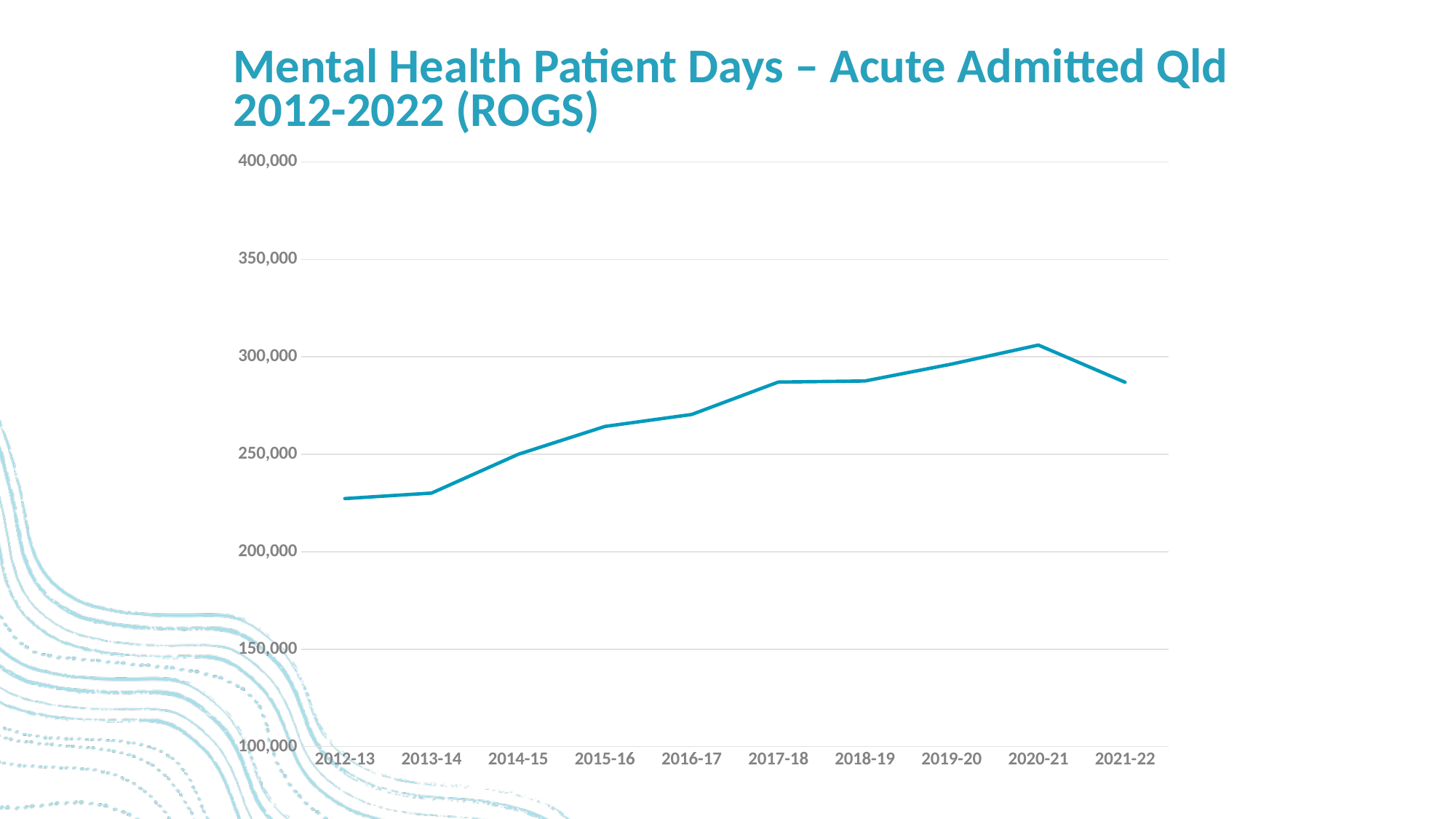
Is the value for 2021-22 greater or less than 300,000? less What is the title of the chart? Mental Health Patient Days – Acute Admitted Qld 2012-2022 (ROGS) Do the values rise or fall from 2012-13 to 2020-21? Rise What kind of chart is shown on the slide? Line chart Which has the larger value, 2020-21 or 2021-22? 2020-21 Is the value for 2020-21 greater or less than 300,000? greater How many financial years are plotted on the x axis? 10 Which financial year has the highest number of mental health patient days? 2020-21 Is the value for 2015-16 greater or less than 250,000? greater Which has the larger value, 2014-15 or 2017-18? 2017-18 Do the values rise or fall from 2020-21 to 2021-22? Fall